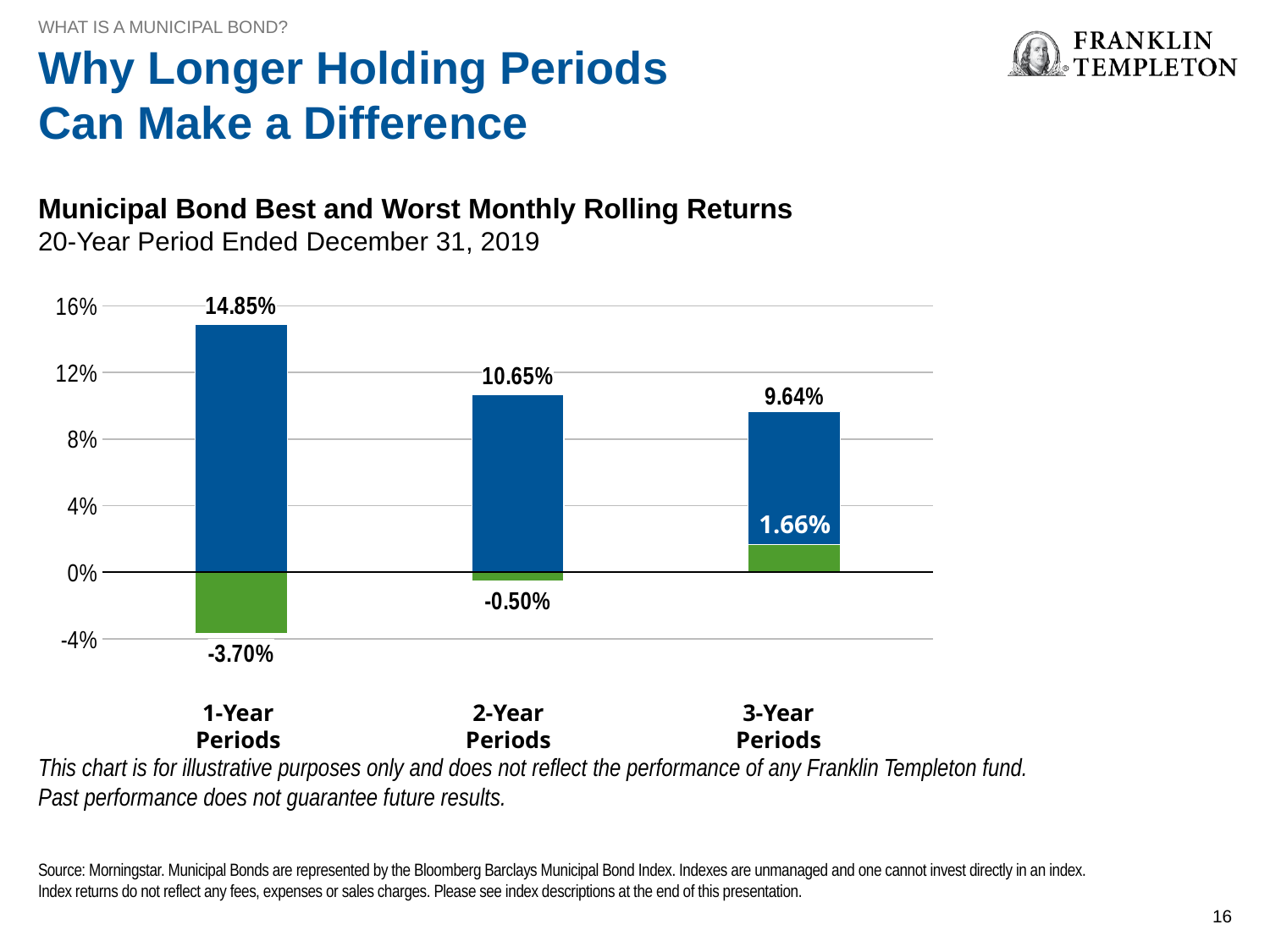
What kind of chart is shown on the slide? Bar chart Which holding period has the lowest worst return? 1-Year Periods Do the best returns rise or fall as the holding period lengthens from 1-Year to 3-Year Periods? Fall What is the worst monthly rolling return shown for 3-Year Periods? 1.66% What is the difference between the best return for 1-Year Periods and the best return for 2-Year Periods? 4.20 percentage points What is the worst monthly rolling return shown for 2-Year Periods? -0.50% What is the best monthly rolling return shown for 3-Year Periods? 9.64% How many holding period categories are shown on the chart? 3 What is the difference between the best return for 2-Year Periods and the best return for 3-Year Periods? 1.01 percentage points Which holding period has the highest best return? 1-Year Periods What is the best monthly rolling return shown for 1-Year Periods? 14.85% Which is larger, the worst return for 2-Year Periods or the worst return for 3-Year Periods? 3-Year Periods